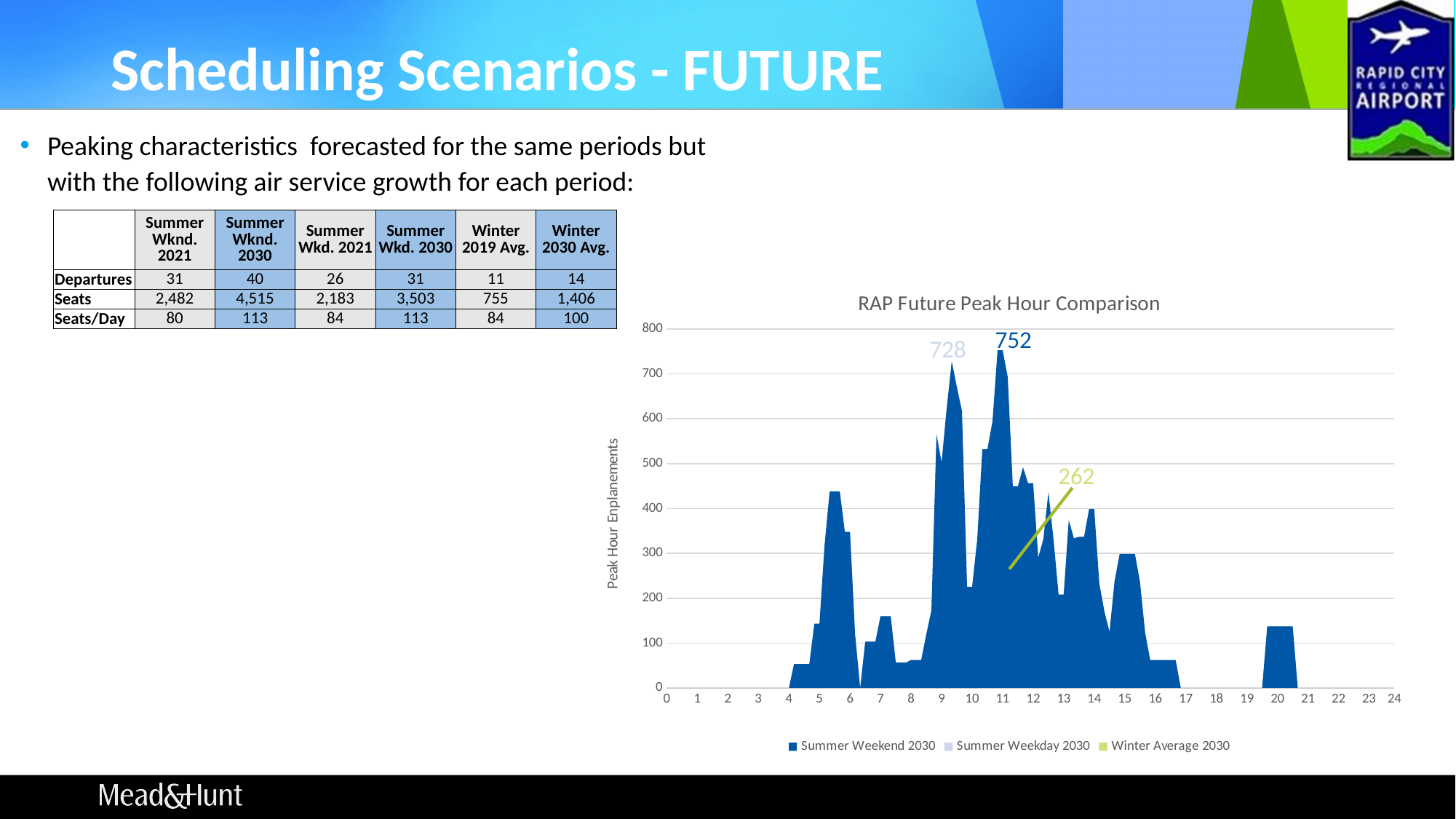
Which series has the highest labeled peak hour enplanements? Summer Weekend 2030 What kind of chart is shown on the slide? Area chart What is the labeled peak value for Winter Average 2030? 262 Is the Summer Weekend 2030 value at hour 20 greater or less than 200? less Which labeled peak is larger, Summer Weekday 2030 or Winter Average 2030? Summer Weekday 2030 What is the difference between the labeled peaks for Summer Weekend 2030 and Winter Average 2030? 490 What is the labeled peak value for Summer Weekend 2030? 752 What is the labeled peak value for Summer Weekday 2030? 728 What is the title of the chart on the slide? RAP Future Peak Hour Comparison Which series has the lowest labeled peak hour enplanements? Winter Average 2030 How many series does the chart legend list? 3 What is the difference between the labeled peaks for Summer Weekend 2030 and Summer Weekday 2030? 24